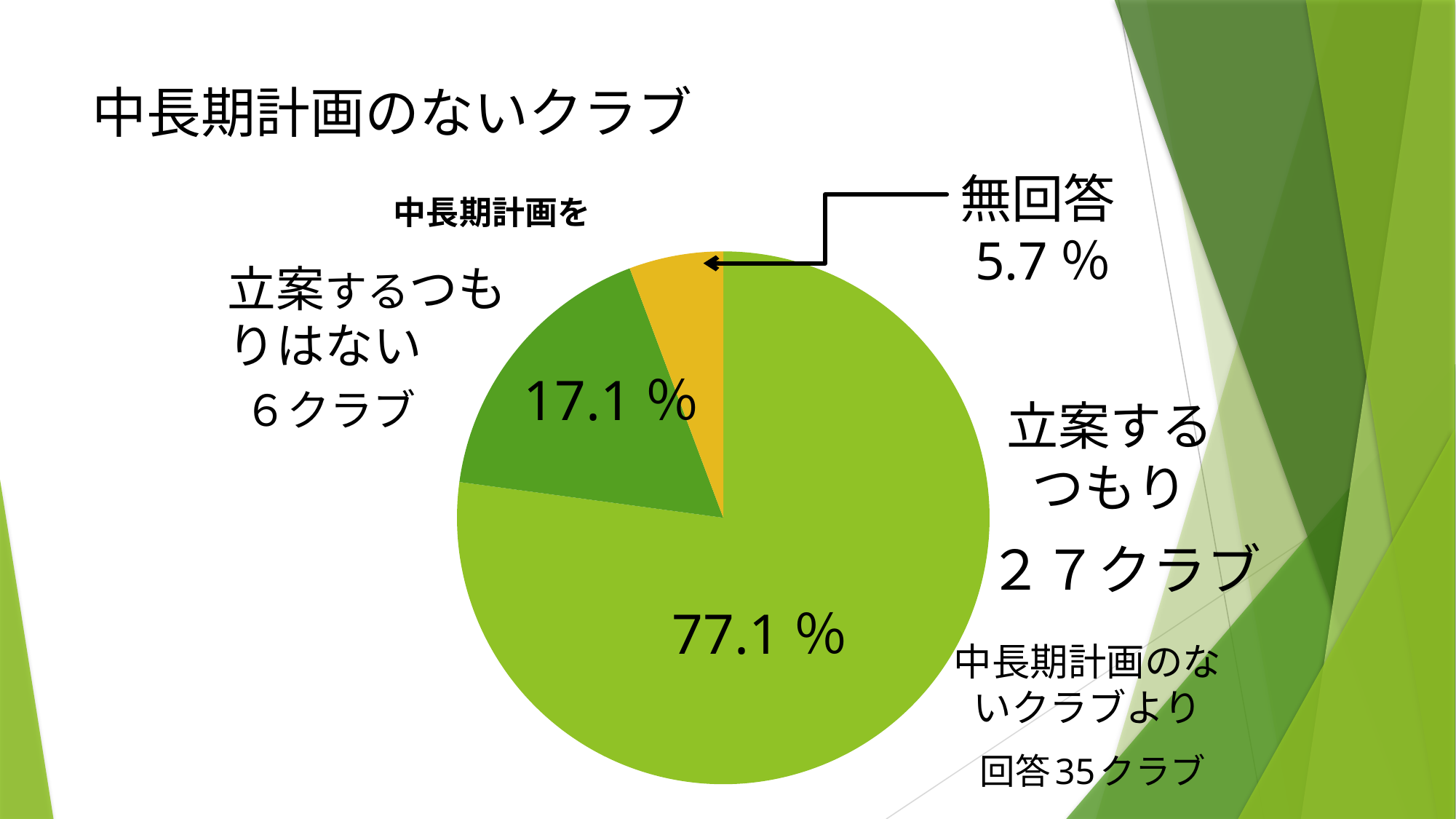
How many slices does the pie chart have? 3 What percentage of the pie chart is the 立案するつもり slice? 77.1 % Which category has the smallest slice of the pie chart? 無回答 How many clubs answered 立案するつもり according to the slide? 27 clubs What is the title printed above the pie chart? 中長期計画を What percentage of the pie chart is the 立案するつもりはない slice? 17.1 % What percentage of the pie chart is the 無回答 slice? 5.7 % How many clubs answered 立案するつもりはない according to the slide? 6 clubs By how many percentage points does the 立案するつもり slice exceed the 立案するつもりはない slice? 60.0 percentage points What kind of chart is shown on the slide? Pie chart Which category has the largest slice of the pie chart? 立案するつもり Which slice is larger, 立案するつもりはない or 無回答? 立案するつもりはない